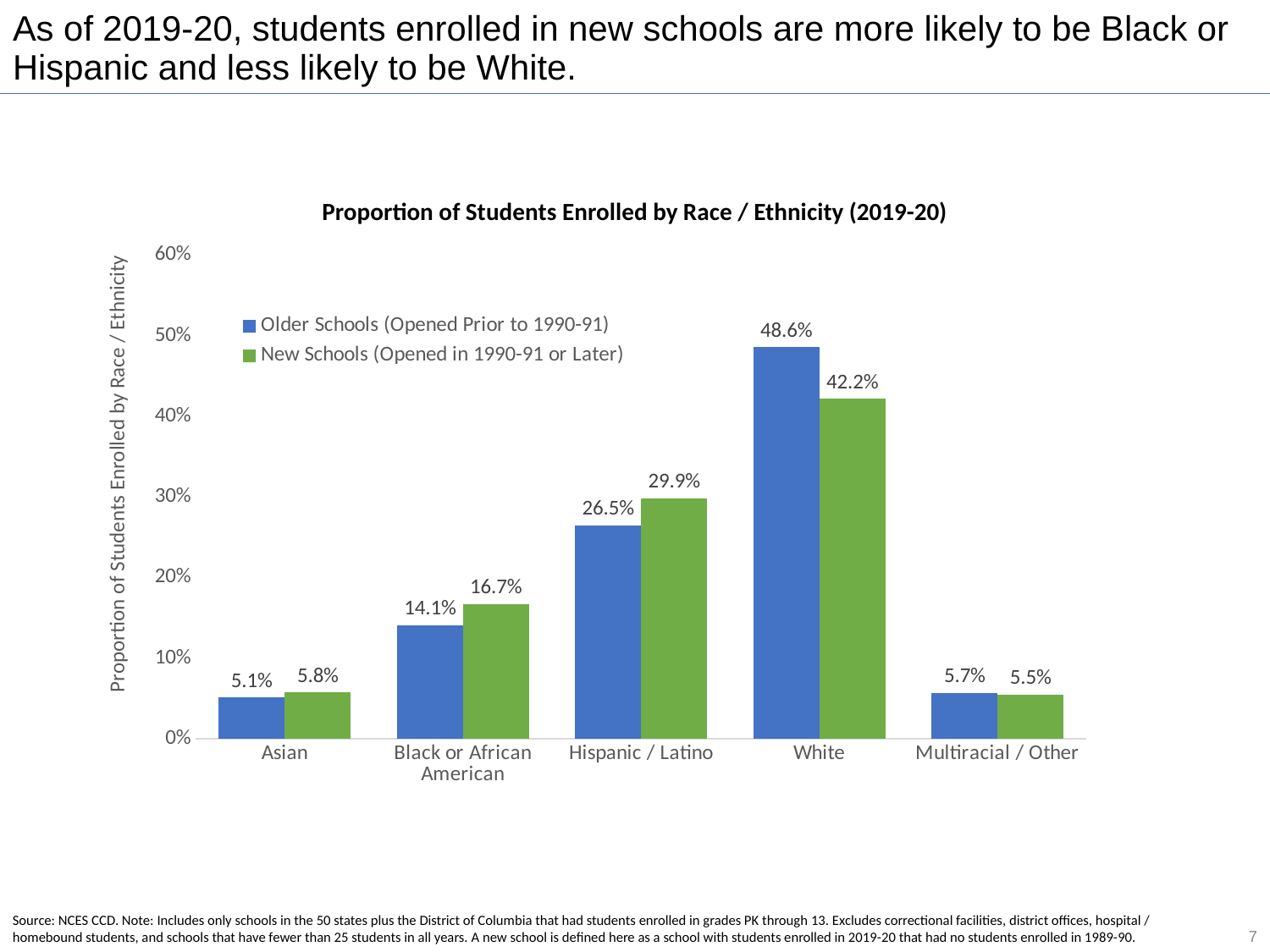
How many series does the legend list? 2 Which category has the highest value in the New Schools series? White What is the value for Hispanic / Latino in the New Schools (Opened in 1990-91 or Later) series? 29.9% What is the difference between the Older Schools and New Schools values for White? 6.4% How many race / ethnicity categories are shown on the x axis? 5 What is the title of the chart? Proportion of Students Enrolled by Race / Ethnicity (2019-20) What is the value for Black or African American in the Older Schools series? 14.1% Is the Older Schools value for Hispanic / Latino greater or less than 30%? less What is the value for White in the Older Schools (Opened Prior to 1990-91) series? 48.6% Which category has the lowest value in the Older Schools series? Asian What kind of chart is shown on the slide? bar chart Which is larger for Black or African American: the Older Schools value or the New Schools value? New Schools